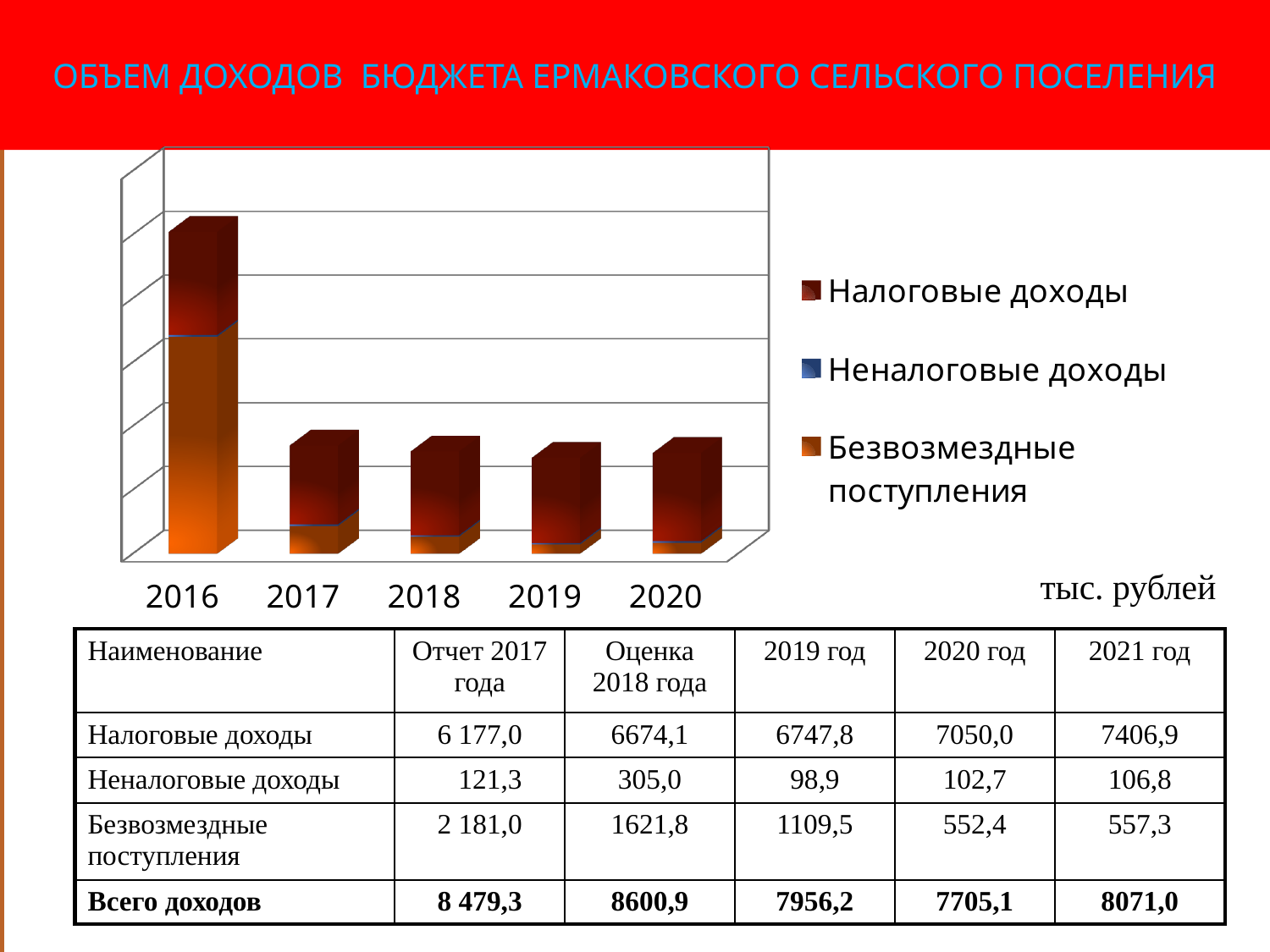
What is the first year shown on the x axis of the chart? 2016 Which bar is taller in the chart, 2016 or 2017? 2016 What is the first series listed in the chart legend? Налоговые доходы Do the total bar heights in the chart generally rise or fall from 2016 to 2020? Fall Which year has the tallest bar in the chart? 2016 What kind of chart is shown on the slide? Stacked bar chart Which series forms the largest segment of the 2017 bar in the chart? Налоговые доходы Which bar is taller in the chart, 2016 or 2020? 2016 How many years are shown on the x axis of the chart? 5 How many series does the chart legend list? 3